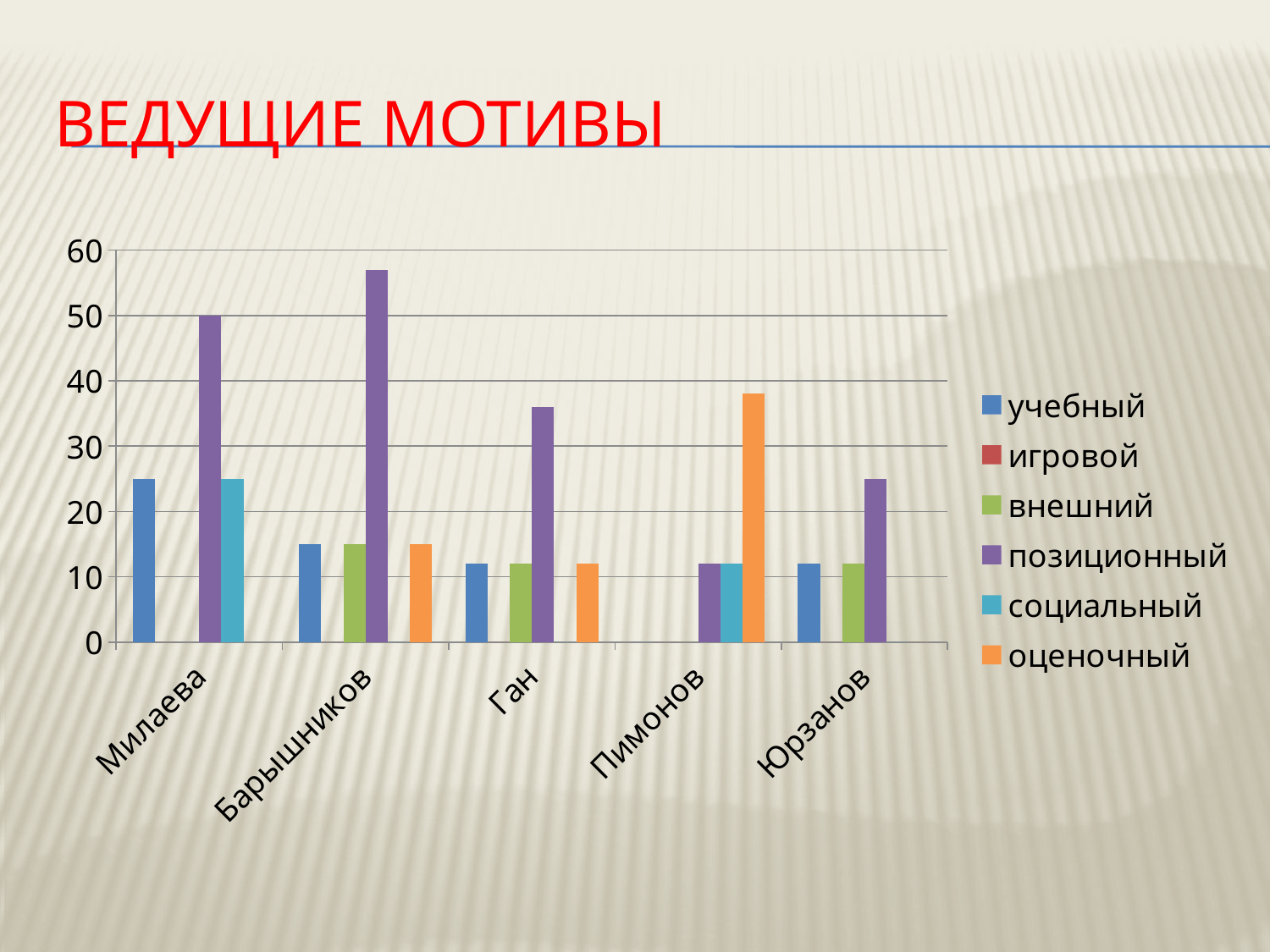
Which category has the tallest позиционный bar? Барышников Which is larger: the позиционный value for Милаева or the позиционный value for Ган? Милаева How many categories (people) are shown on the x axis? 5 Is the оценочный value for Пимонов greater or less than 40? less What is the title of the slide containing the chart? ВЕДУЩИЕ МОТИВЫ Which series is shown in orange in the legend? оценочный Is the позиционный value for Барышников greater or less than 50? greater Is the позиционный value for Ган greater or less than 30? greater How many series does the legend list? 6 What is the value of the позиционный bar for Милаева? 50 What kind of chart is shown on the slide? bar chart